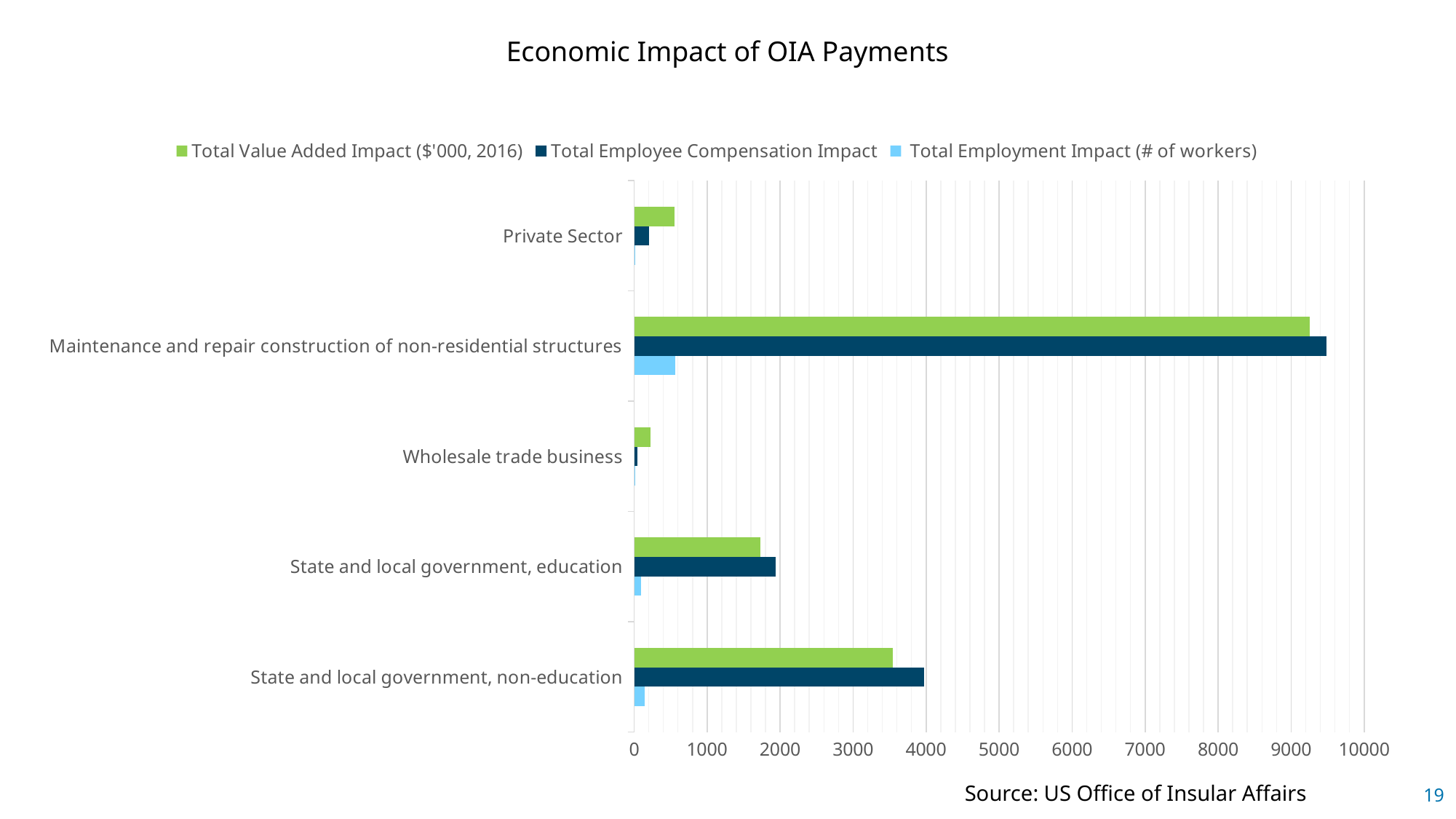
Is the Total Value Added Impact for State and local government, non-education greater or less than 3000? greater How many series does the legend list? 3 Which category has the lowest Total Value Added Impact? Wholesale trade business Which category has the highest Total Value Added Impact? Maintenance and repair construction of non-residential structures How many categories are shown on the chart? 5 Is the Total Employment Impact (# of workers) for Maintenance and repair construction of non-residential structures greater or less than 1000? less Is the Total Employee Compensation Impact for Maintenance and repair construction of non-residential structures greater or less than 9000? greater Which category has the highest Total Employment Impact (# of workers)? Maintenance and repair construction of non-residential structures For State and local government, non-education, which is larger: the Total Value Added Impact or the Total Employee Compensation Impact? Total Employee Compensation Impact What kind of chart is shown on the slide? Bar chart What is the title of the chart? Economic Impact of OIA Payments